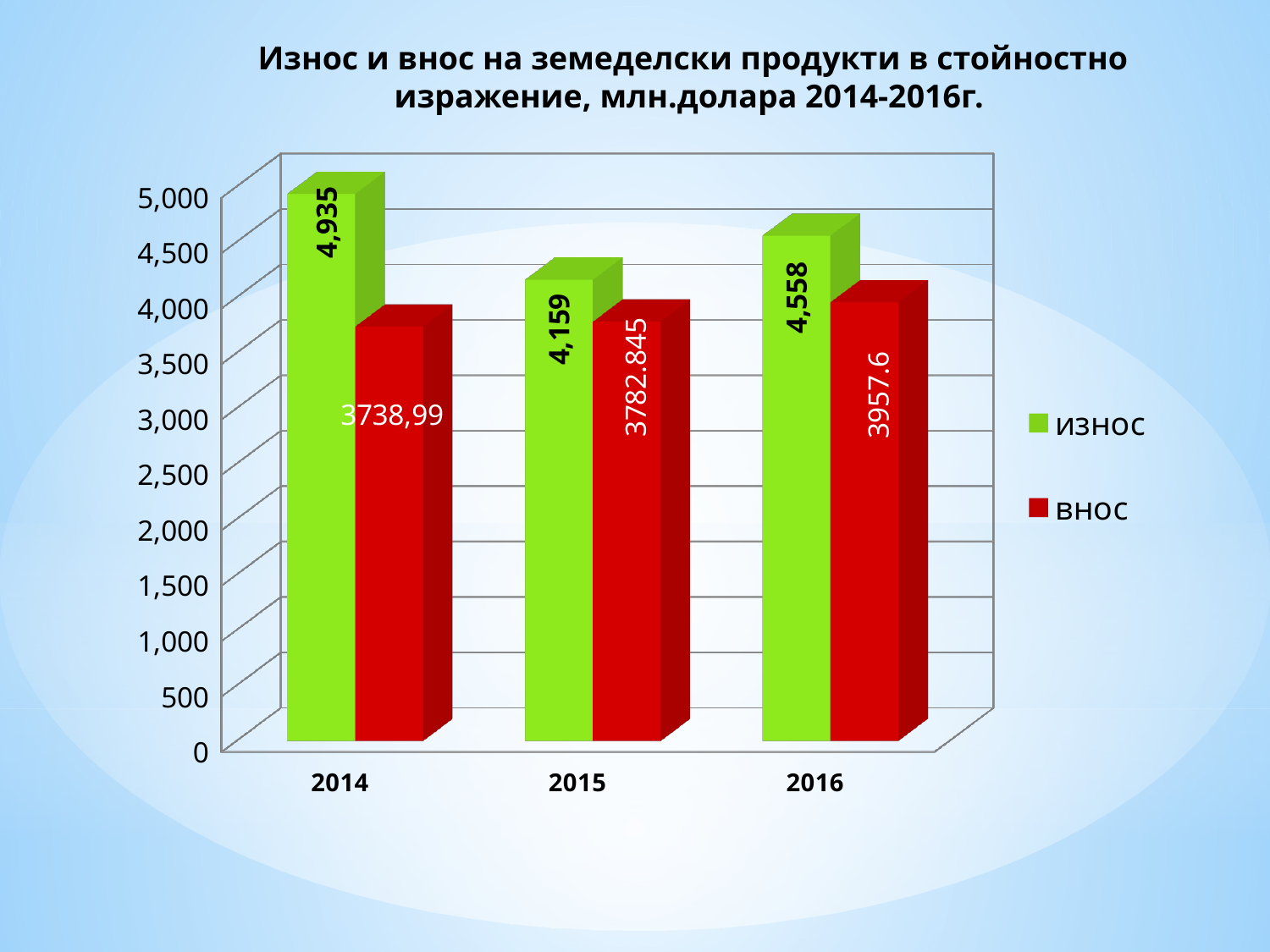
Is the value for внос in 2014 greater or less than 4,000? less In which year is износ the highest? 2014 Which is larger in 2015, износ or внос? износ In which year is внос the lowest? 2014 Do the values for внос rise or fall from 2014 to 2016? rise What is the value for внос in 2015? 3782.845 What is the value for износ in 2014? 4,935 What is the difference between износ in 2014 and износ in 2016? 377 How many series does the legend list? 2 How many years are shown on the x axis? 3 What is the value for внос in 2016? 3957.6 What is the value for износ in 2016? 4,558